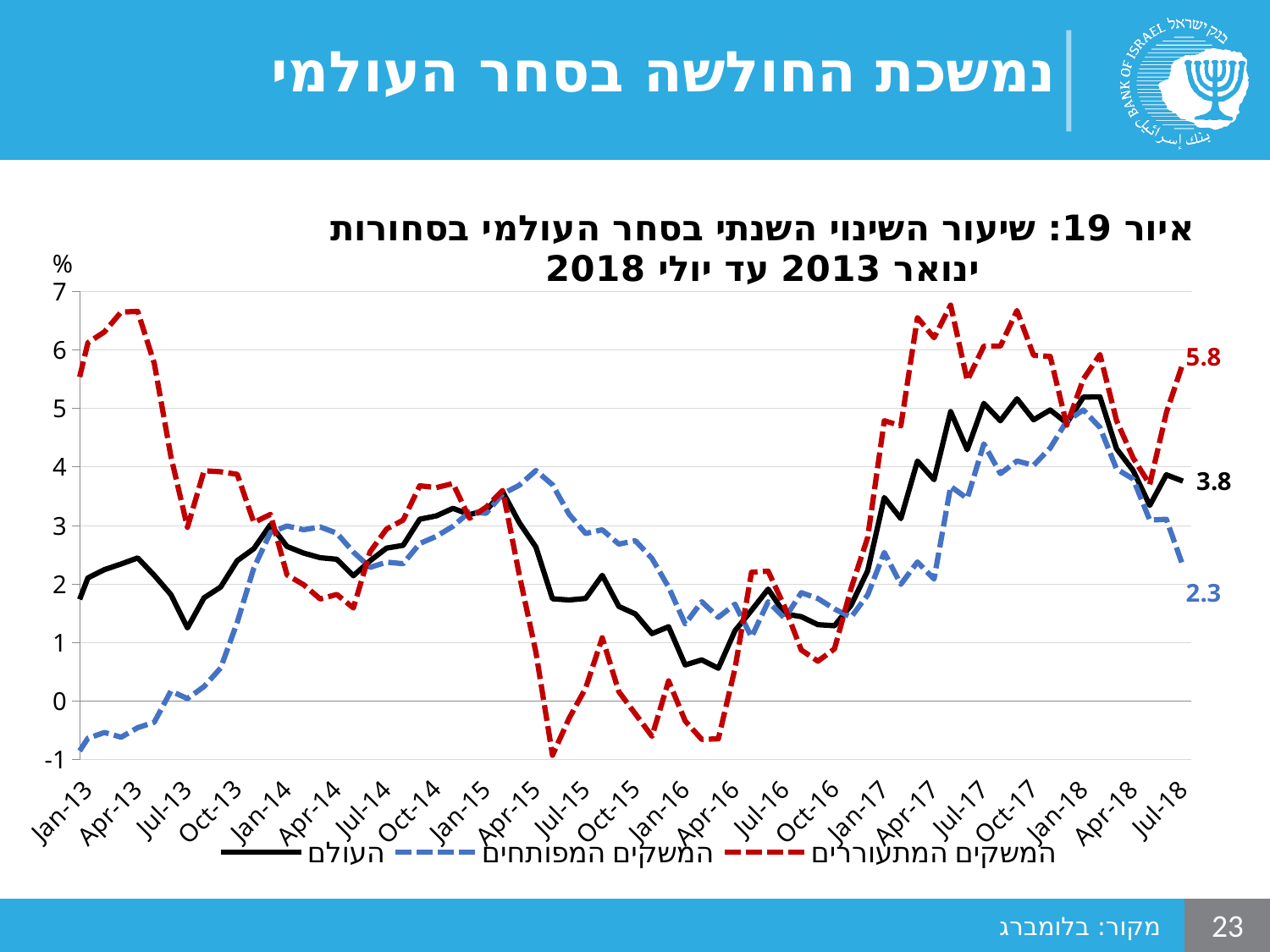
Which series has the lowest value at Jul-18? המשקים המפותחים What kind of chart is shown on the slide? line chart What is the value for המשקים המפותחים (developed markets) at the end of the series, Jul-18? 2.3 How many series does the legend list? 3 What is the value for המשקים המתעוררים (emerging markets) at the end of the series, Jul-18? 5.8 Does the value for המשקים המפותחים rise or fall between Jan-18 and Jul-18? fall Which series has the highest value at Jul-18? המשקים המתעוררים What is the difference between the Jul-18 values of המשקים המתעוררים and המשקים המפותחים? 3.5 Is the value for המשקים המתעוררים at Jan-13 greater or less than 5? greater Is the value for המשקים המפותחים at Jan-13 greater or less than 0? less At Jul-18, which is larger: the value for העולם or the value for המשקים המפותחים? העולם What is the value for העולם (world) at the end of the series, Jul-18? 3.8